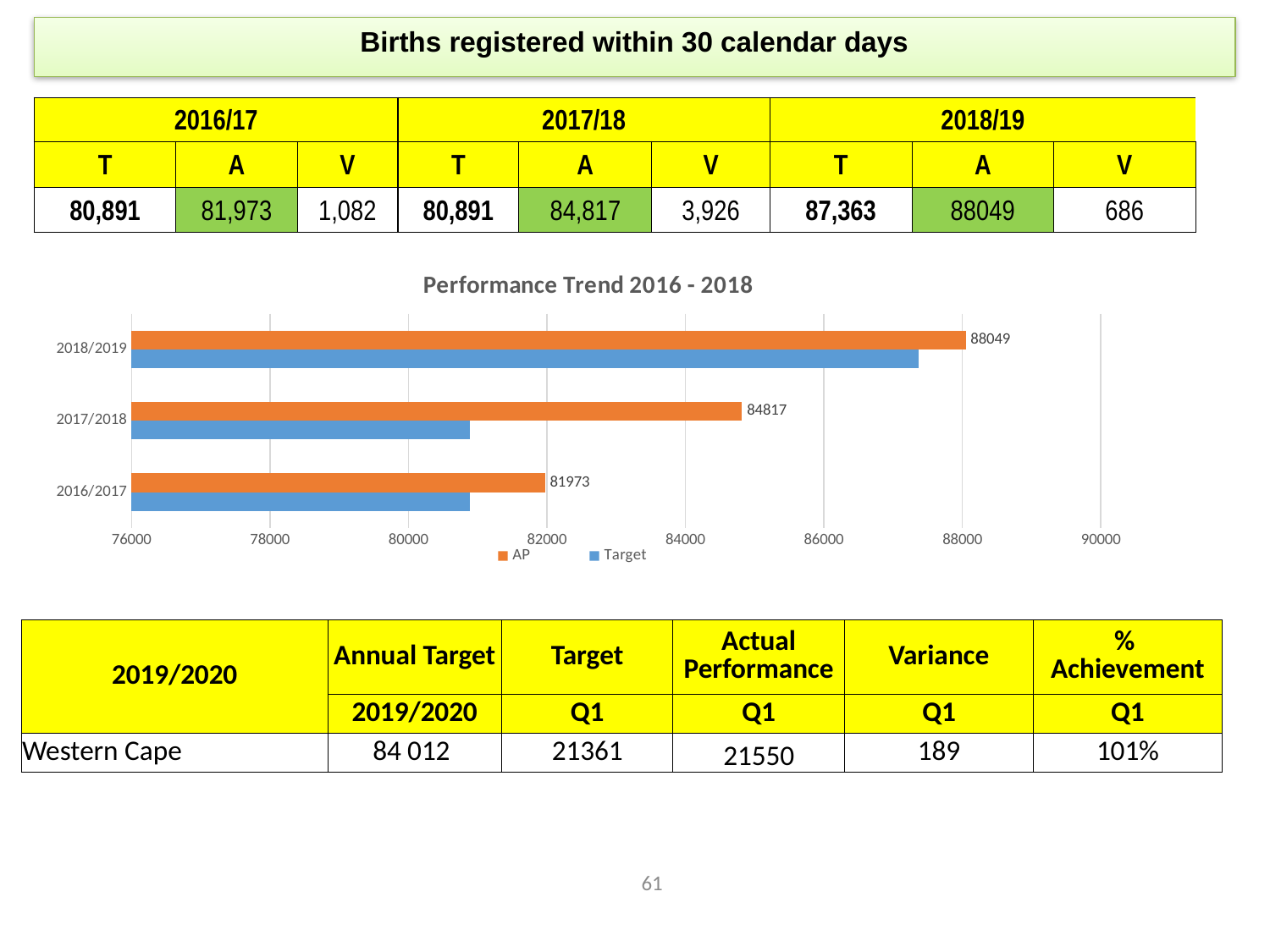
How many years are shown in the Performance Trend chart? 3 How many series does the legend of the Performance Trend chart list? 2 In the Performance Trend chart, is the AP value for 2017/2018 larger or smaller than the AP value for 2016/2017? larger Which year has the lowest AP value in the Performance Trend chart? 2016/2017 In the Performance Trend chart, is the Target value for 2018/2019 greater or less than 86000? greater What is the AP value for 2017/2018 in the Performance Trend chart? 84817 What type of chart is the Performance Trend 2016 - 2018 chart? Bar chart What is the difference between the AP values for 2018/2019 and 2017/2018 in the Performance Trend chart? 3232 In the Performance Trend chart, is the Target value for 2016/2017 greater or less than 82000? less Which year has the highest AP value in the Performance Trend chart? 2018/2019 What is the AP value for 2018/2019 in the Performance Trend chart? 88049 What is the AP value for 2016/2017 in the Performance Trend chart? 81973